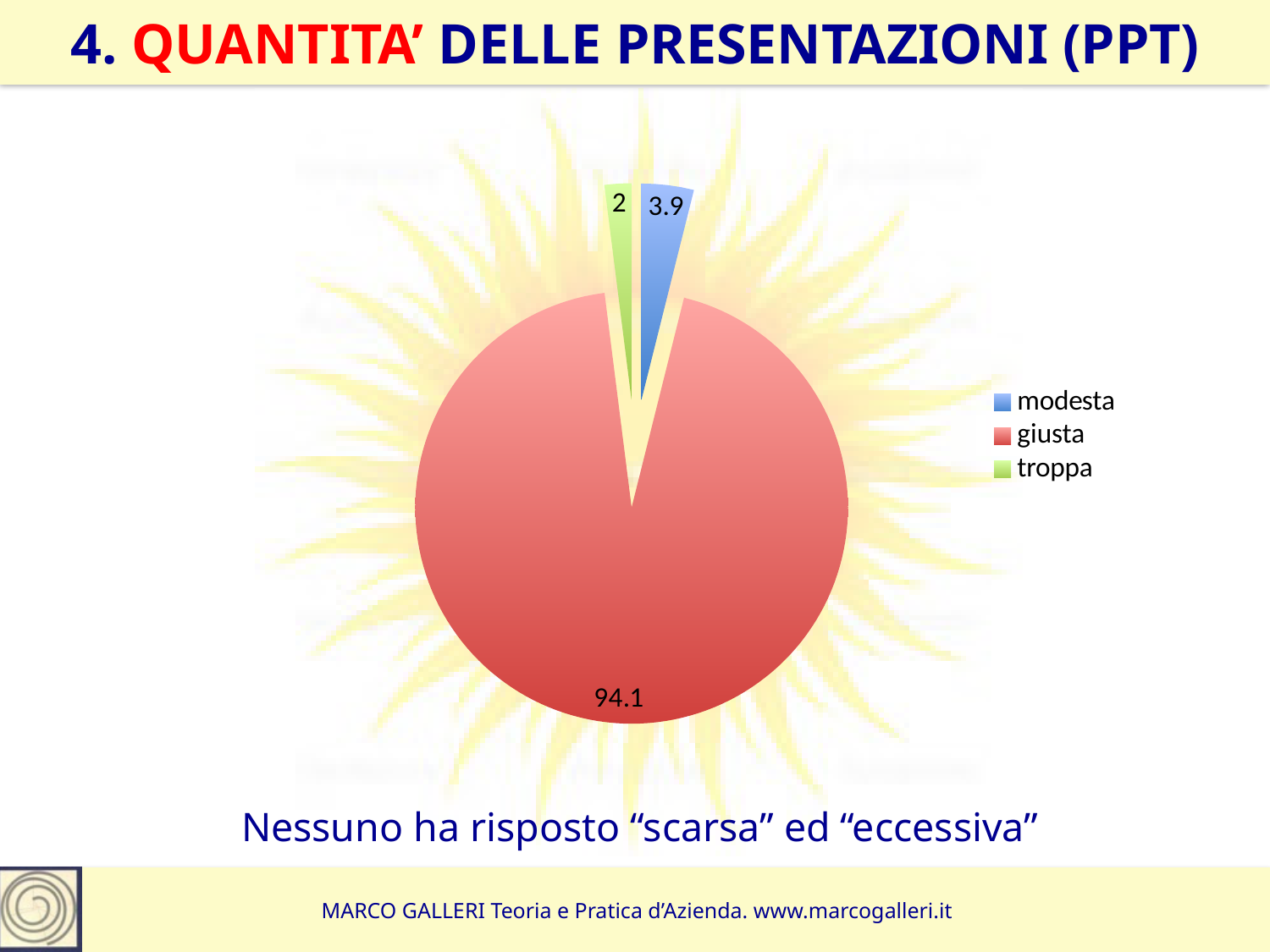
What is the value for "modesta" in the pie chart? 3.9 How many entries does the legend list? 3 Which is larger, the value for "modesta" or the value for "troppa"? modesta What is the value for "troppa" in the pie chart? 2 What is the difference between the values for "modesta" and "troppa"? 1.9 What kind of chart is shown on the slide? pie chart What colour is the "giusta" slice in the pie chart? red What is the value for "giusta" in the pie chart? 94.1 What is the difference between the values for "giusta" and "modesta"? 90.2 How many slices does the pie chart have? 3 Which category has the largest slice of the pie? giusta Which category has the smallest slice of the pie? troppa